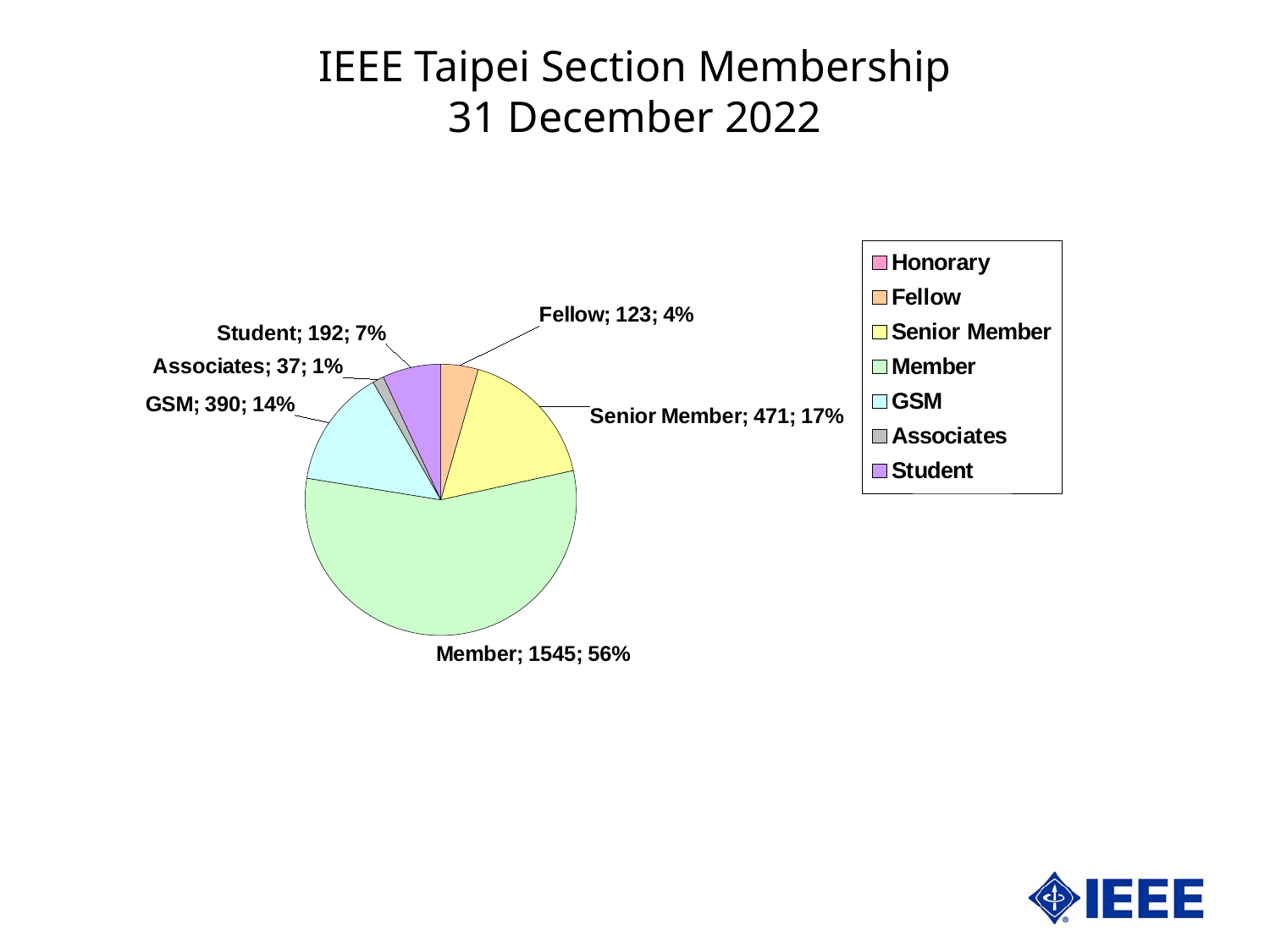
What kind of chart is shown on the slide? pie chart Which labelled category has the smallest slice of the pie? Associates What percentage of the membership is Senior Member? 17% How many entries does the legend list? 7 What is the title of the chart on the slide? IEEE Taipei Section Membership 31 December 2022 What is the value shown for GSM? 390 What is the value shown for Fellow? 123 What share of the pie does the Student slice represent? 7% How many members are in the Member category? 1545 Which category has the largest slice of the pie? Member Which is larger, the Student count or the Fellow count? Student What is the difference between the Senior Member count and the GSM count? 81